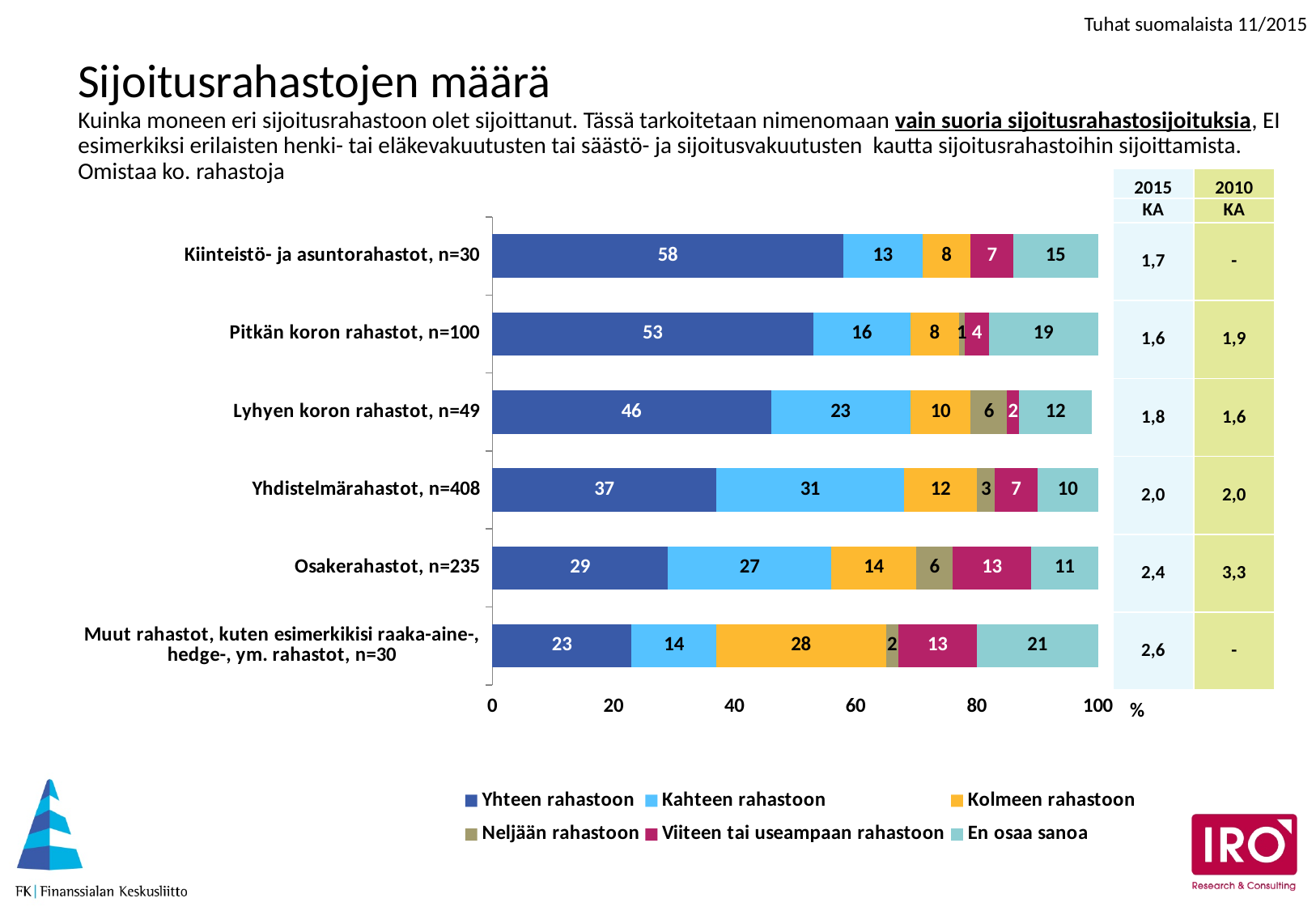
What is the difference between the 'Kahteen rahastoon' values for Yhdistelmärahastot, n=408 and Kiinteistö- ja asuntorahastot, n=30? 18 How many series does the legend list? 6 What kind of chart is shown on the slide? Stacked bar chart What is the value for 'Kolmeen rahastoon' in the 'Muut rahastot, kuten esimerkikisi raaka-aine-, hedge-, ym. rahastot, n=30' bar? 28 How many fund categories are shown in the chart? 6 Which category has the highest value for 'Kolmeen rahastoon'? Muut rahastot, kuten esimerkikisi raaka-aine-, hedge-, ym. rahastot, n=30 What is the value for 'Yhteen rahastoon' in the Osakerahastot, n=235 bar? 29 Which has a larger 'En osaa sanoa' value: Pitkän koron rahastot, n=100 or Muut rahastot, n=30? Muut rahastot, n=30 What is the value for 'Neljään rahastoon' in the Lyhyen koron rahastot, n=49 bar? 6 What is the value for 'Viiteen tai useampaan rahastoon' in the Osakerahastot, n=235 bar? 13 Which category has the highest value for 'Yhteen rahastoon'? Kiinteistö- ja asuntorahastot, n=30 Which category has the lowest value for 'Yhteen rahastoon'? Muut rahastot, kuten esimerkikisi raaka-aine-, hedge-, ym. rahastot, n=30